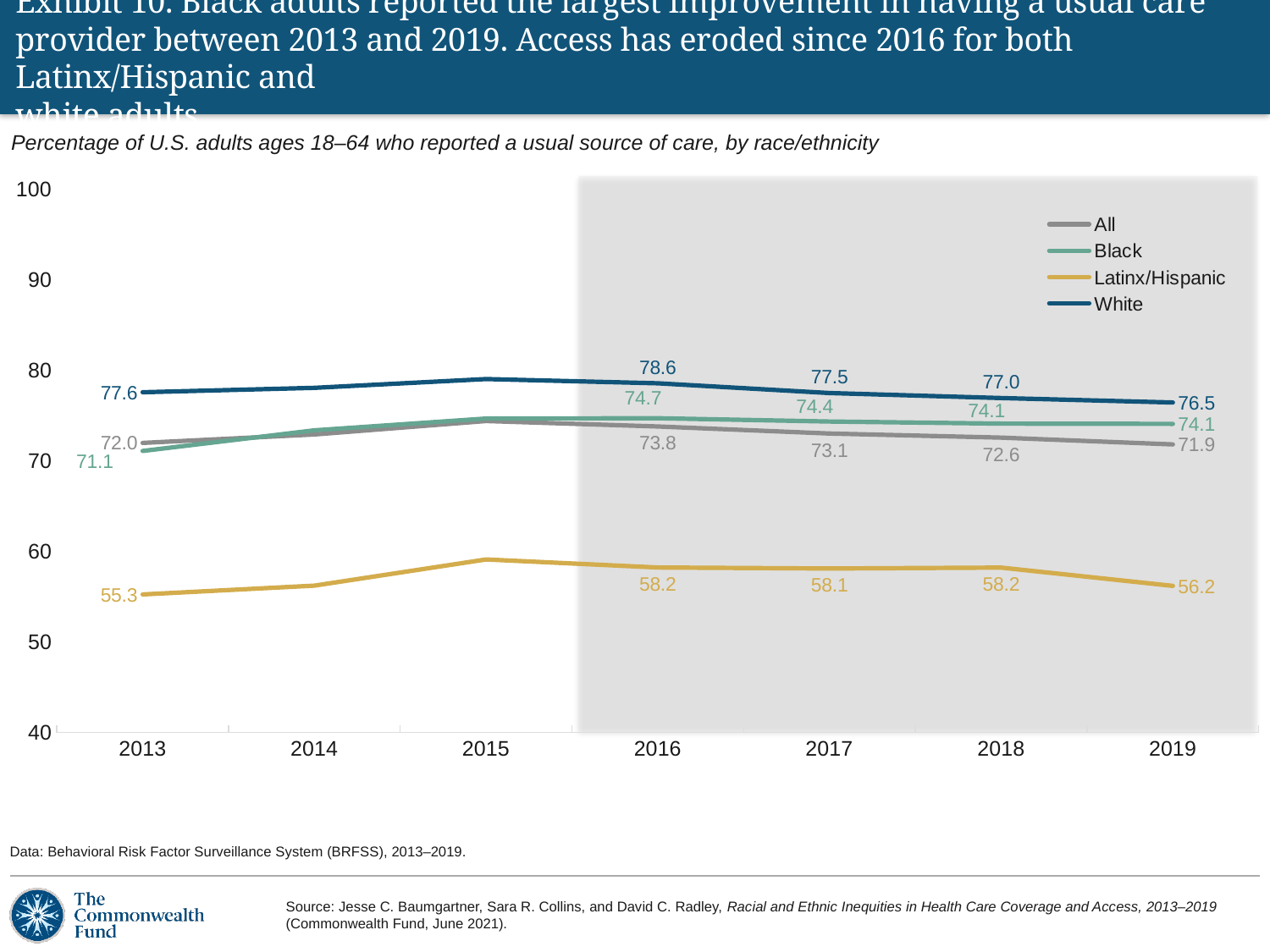
Which group had the highest value in 2013? White Which group had the lowest value in 2019? Latinx/Hispanic Is the value for Latinx/Hispanic adults in 2015 greater or less than 60? less What was the value for Black adults in 2013? 71.1 How many series does the legend list? 4 What was the value for White adults in 2016? 78.6 What was the value for Latinx/Hispanic adults in 2019? 56.2 How many years are shown on the x axis? 7 What was the value for All adults in 2018? 72.6 Which was larger in 2017, the value for Black adults or the value for All adults? Black By how much did the value for Black adults change between 2013 and 2019? 3.0 What type of chart is shown on the slide? Line chart